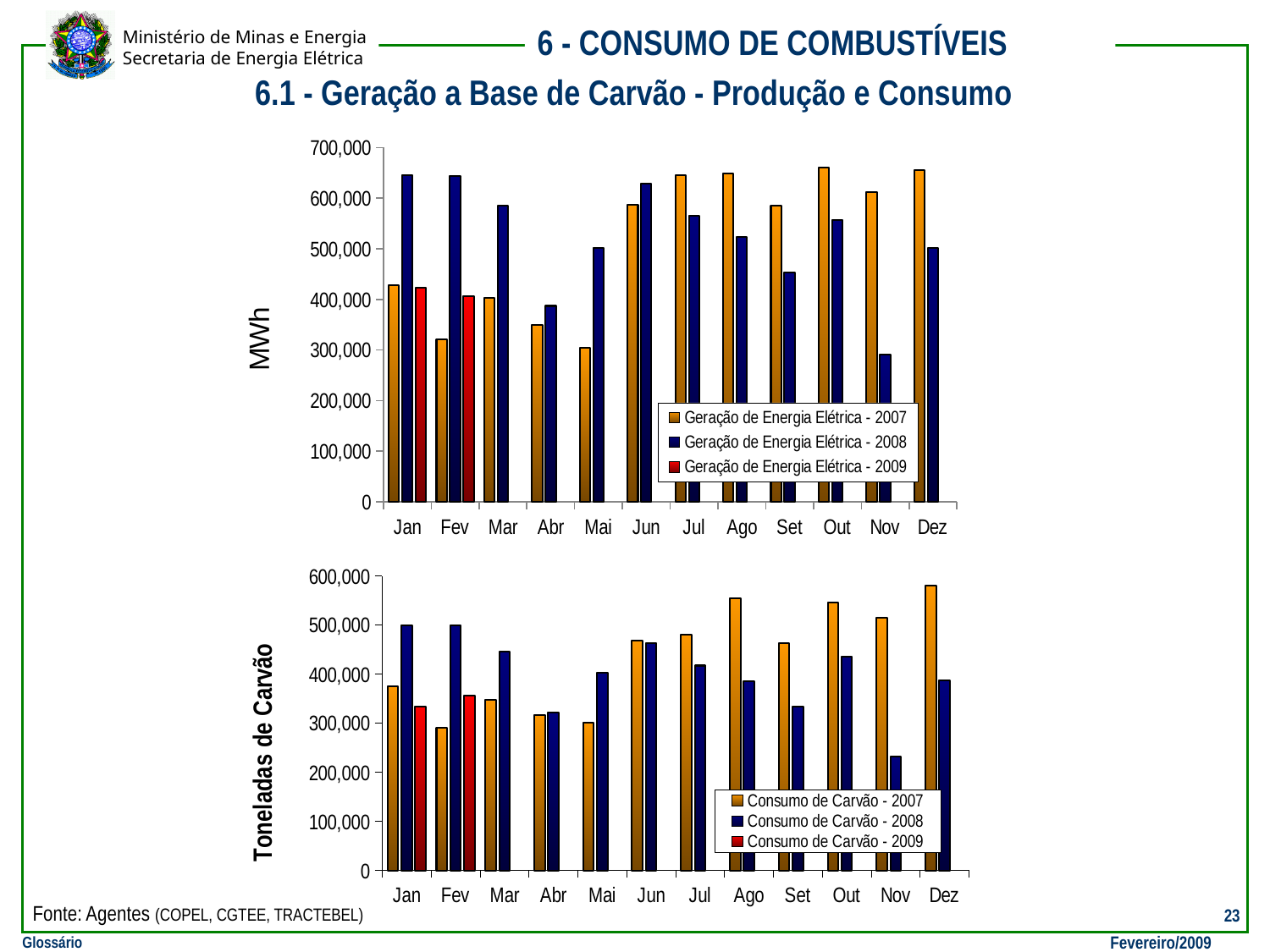
In the bottom chart (Toneladas de Carvão), which is larger in Fev: Consumo de Carvão - 2007 or Consumo de Carvão - 2009? Consumo de Carvão - 2009 In the top chart (MWh), is the value for Geração de Energia Elétrica - 2007 in Jul greater or less than 600,000? greater What is the y-axis label of the bottom chart? Toneladas de Carvão What kind of chart is the top chart (MWh)? Bar chart In the bottom chart (Toneladas de Carvão), which month has the highest value for Consumo de Carvão - 2007? Dez In the bottom chart (Toneladas de Carvão), is the value for Consumo de Carvão - 2008 in Nov greater or less than 300,000? less In the top chart (MWh), how many months are shown on the x axis? 12 In the top chart (MWh), is the value for Geração de Energia Elétrica - 2007 in Fev greater or less than 400,000? less In the top chart (MWh), which month has the lowest value for Geração de Energia Elétrica - 2008? Nov In the bottom chart (Toneladas de Carvão), which month has the lowest value for Consumo de Carvão - 2008? Nov In the top chart (MWh), how many series does the legend list? 3 In the top chart (MWh), which is larger in Jan: Geração de Energia Elétrica - 2007 or Geração de Energia Elétrica - 2008? Geração de Energia Elétrica - 2008